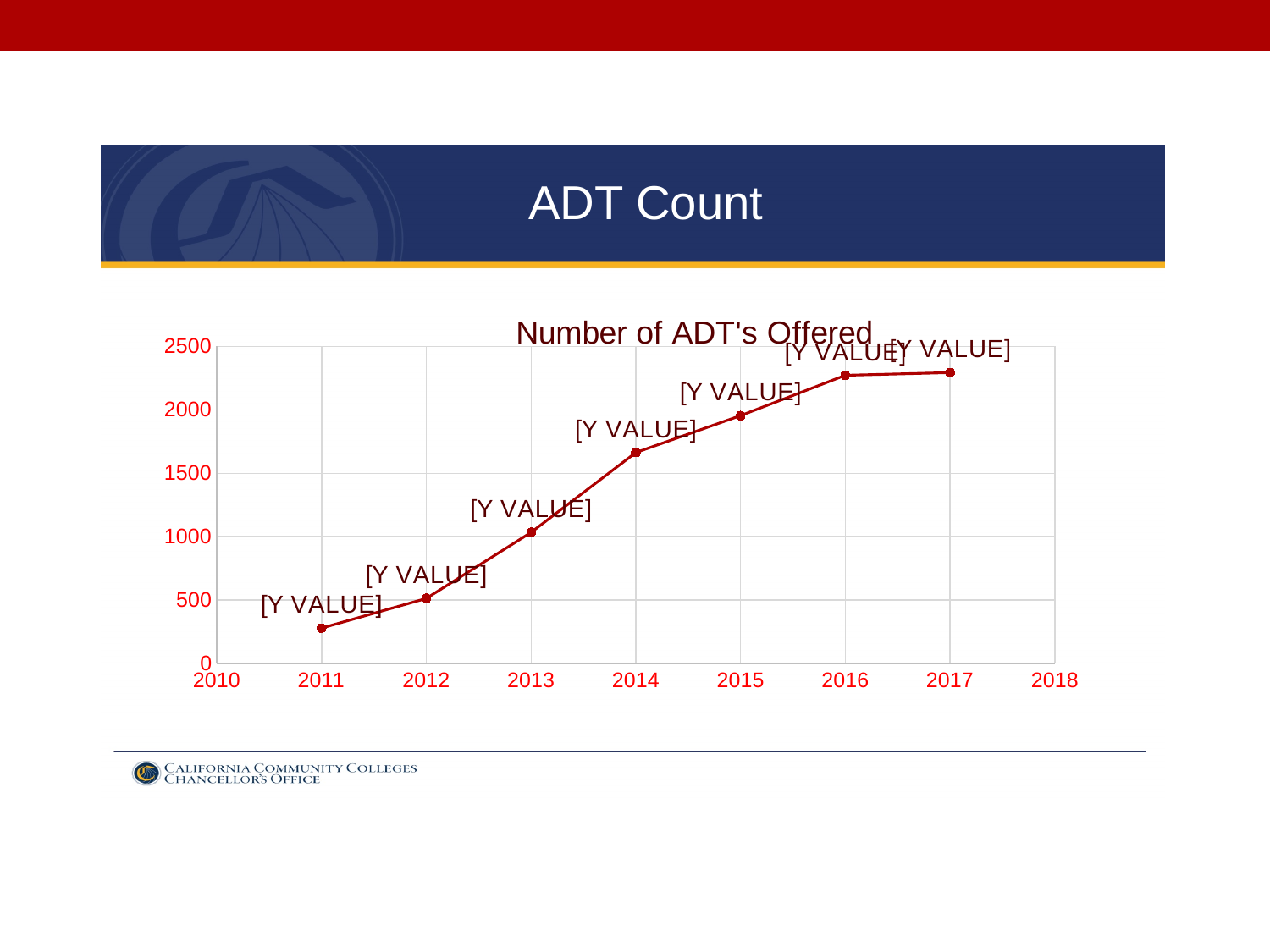
What is the title of the chart? Number of ADT's Offered Which year has the larger value, 2013 or 2014? 2014 How many data points are plotted on the line? 7 Is the value for 2016 greater or less than 2000? greater Which year has the lowest number of ADT's offered? 2011 Is the value for 2011 greater or less than 500? less What kind of chart is shown on the slide? line chart Do the values generally rise or fall from 2011 to 2017? rise Which year has the larger value, 2011 or 2012? 2012 Is the value for 2017 greater or less than 2500? less